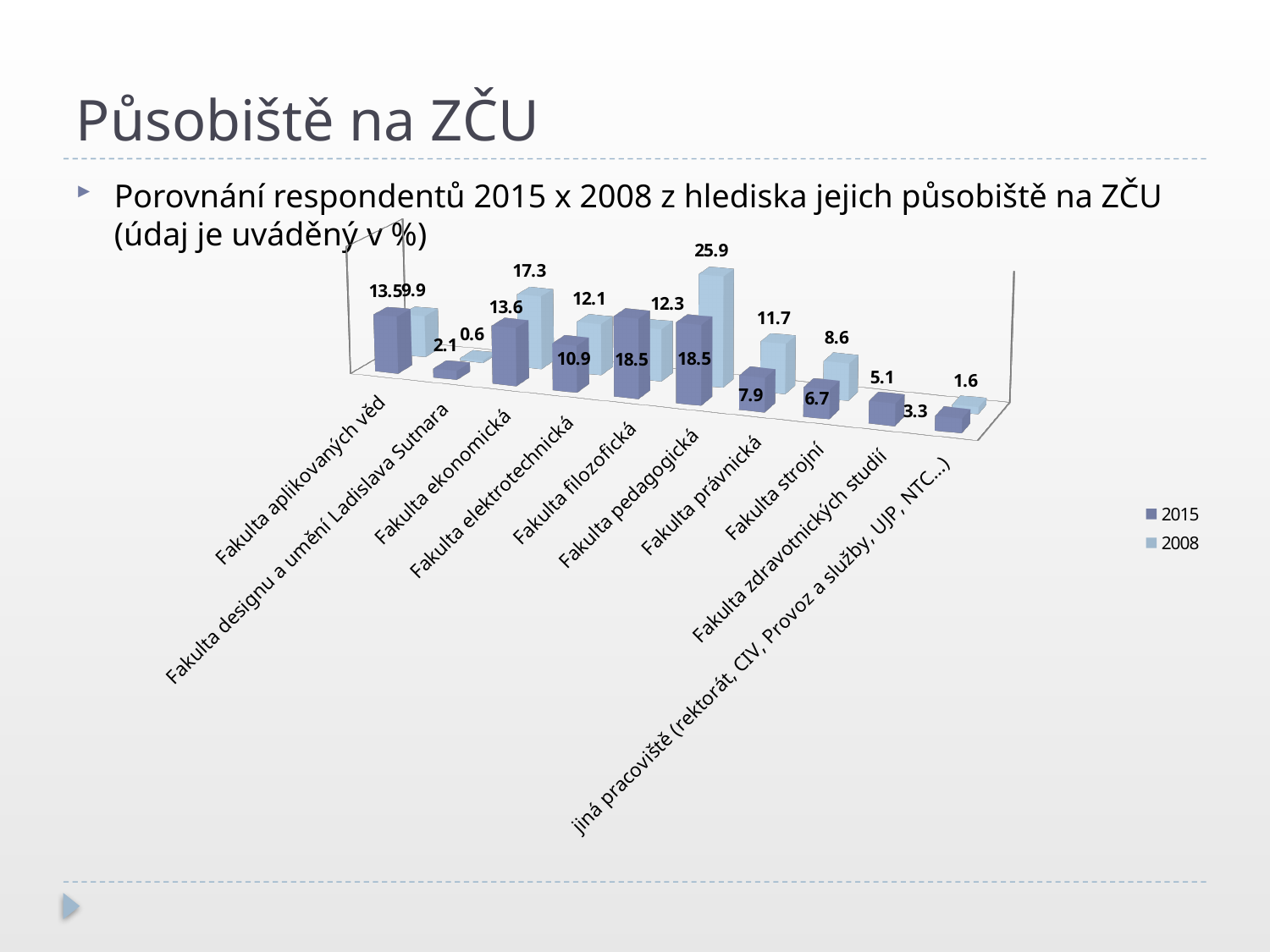
What is the 2015 value for Fakulta právnická? 7.9 Which category has the highest 2008 value? Fakulta pedagogická What is the 2015 value for Fakulta filozofická? 18.5 What is the difference between the 2008 and 2015 values for Fakulta ekonomická? 3.7 What is the 2008 value for Fakulta elektrotechnická? 12.1 How many categories (workplaces) are shown on the x axis? 10 What kind of chart is shown on the slide? bar chart What is the 2008 value for Fakulta pedagogická? 25.9 Which category has the lowest 2008 value? Fakulta designu a umění Ladislava Sutnara How many series does the legend list? 2 For Fakulta strojní, which series has the larger value, 2015 or 2008? 2008 What are the two entries in the legend? 2015 and 2008